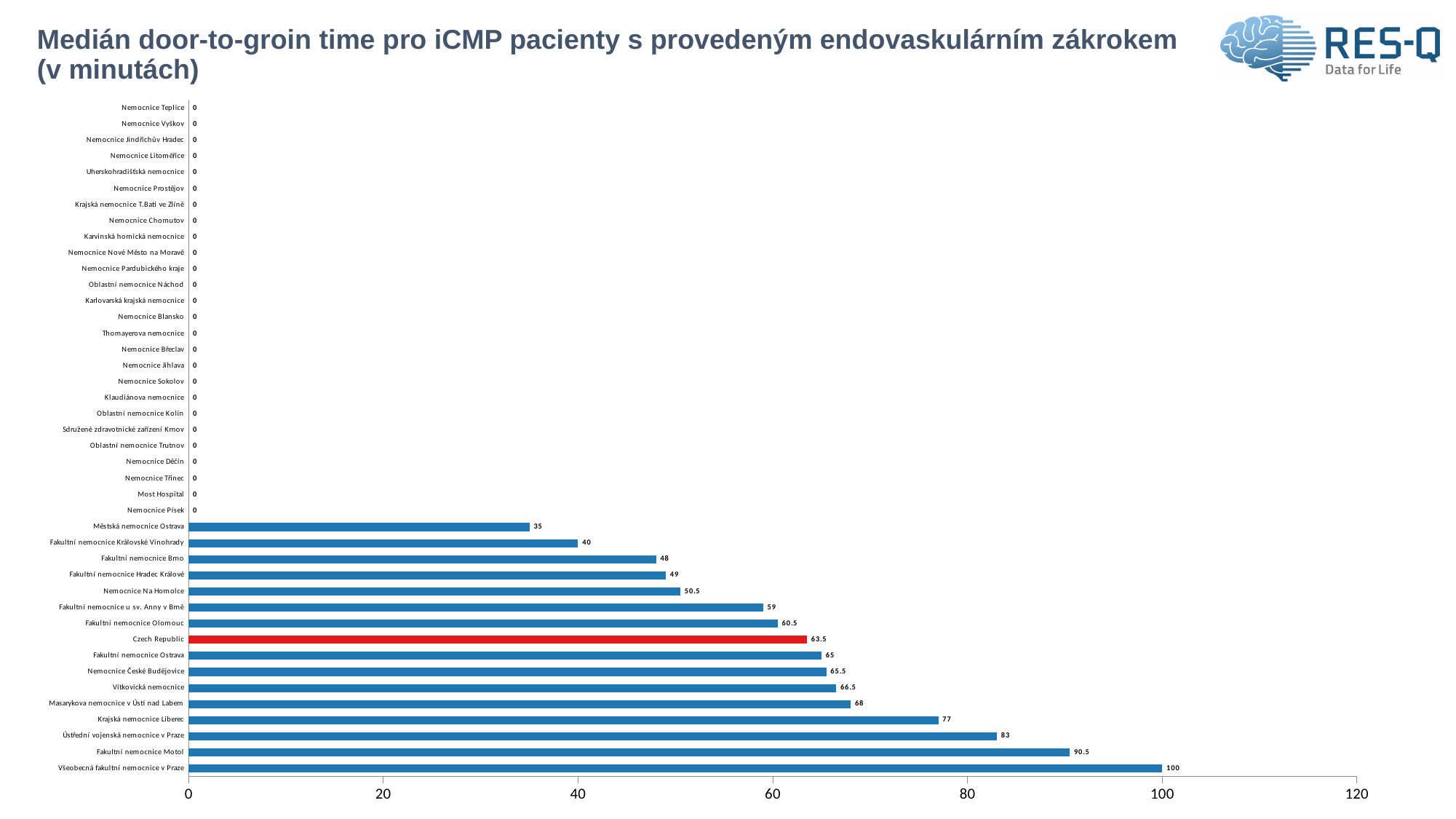
Among hospitals with a non-zero value, which has the lowest median door-to-groin time? Městská nemocnice Ostrava What kind of chart is shown on the slide? bar chart What is the difference between the values for Ústřední vojenská nemocnice v Praze and Fakultní nemocnice Brno? 35 Which hospital has the highest median door-to-groin time? Všeobecná fakultní nemocnice v Praze What is the median door-to-groin time for Fakultní nemocnice Motol? 90.5 What value is shown for Czech Republic? 63.5 Which bar is highlighted in red? Czech Republic Which is larger, the value for Fakultní nemocnice Olomouc or Fakultní nemocnice Ostrava? Fakultní nemocnice Ostrava What is the value for Nemocnice Na Homolce? 50.5 What is the maximum value shown on the horizontal axis? 120 Is the value for Masarykova nemocnice v Ústí nad Labem greater or less than 60? greater What is the value for Krajská nemocnice Liberec? 77